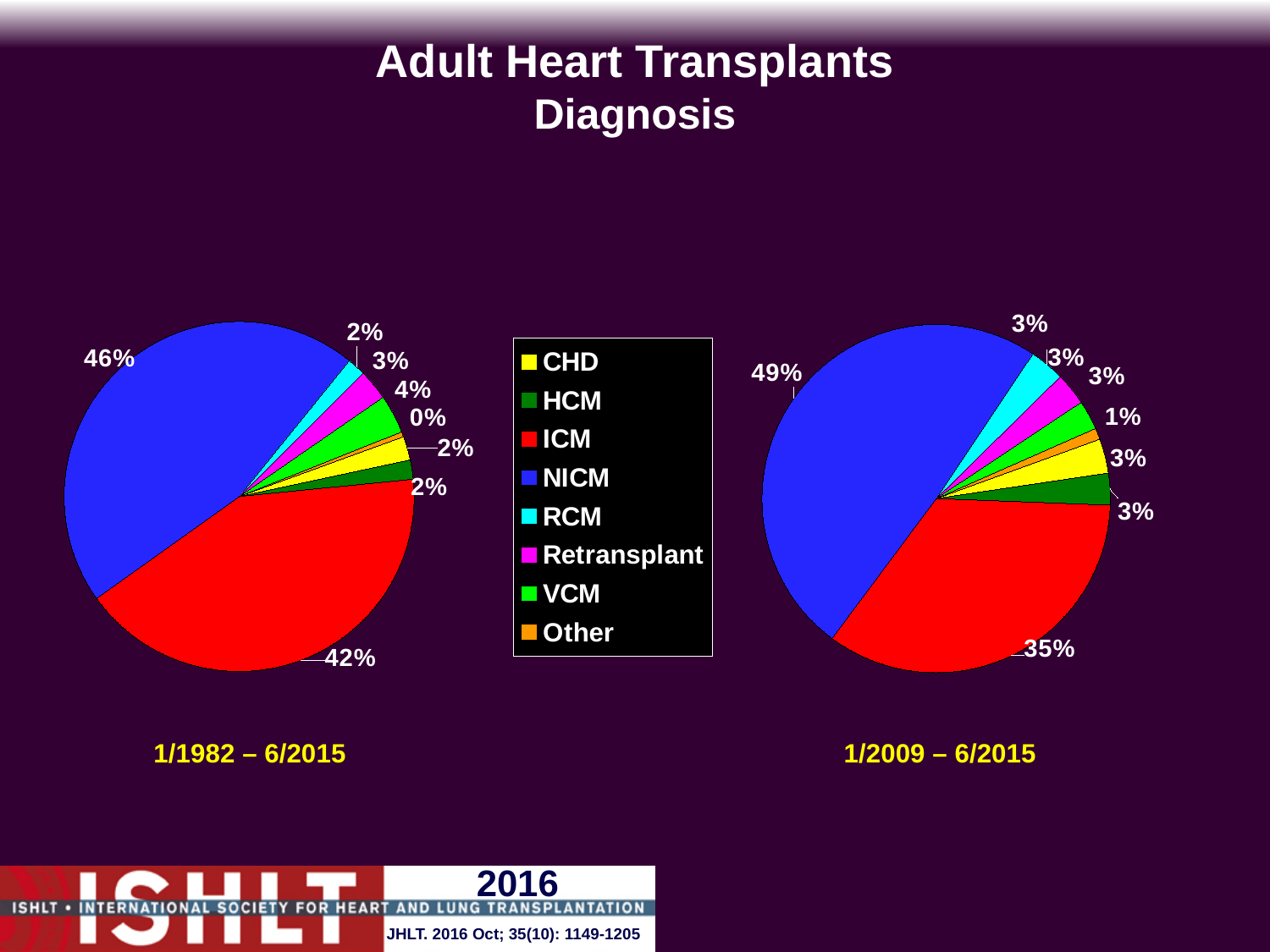
How many diagnosis categories does the legend list? 8 Which colour represents ICM in the legend? Red In the 1/1982 – 6/2015 pie chart, which diagnosis has the smallest share? Other In the 1/1982 – 6/2015 pie chart, what share is ICM? 42% In the 1/2009 – 6/2015 pie chart, what is the difference between the NICM and ICM shares? 14% In the 1/2009 – 6/2015 pie chart, which diagnosis has the smallest share? Other In the 1/1982 – 6/2015 pie chart, what share of adult heart transplants is NICM? 46% In the 1/1982 – 6/2015 pie chart, what is the difference between the NICM and ICM shares? 4% What kind of charts are shown on the slide? Pie charts In the 1/2009 – 6/2015 pie chart, what share is NICM? 49% In the 1/2009 – 6/2015 pie chart, what share is ICM? 35% In the 1/1982 – 6/2015 pie chart, which diagnosis has the largest share? NICM